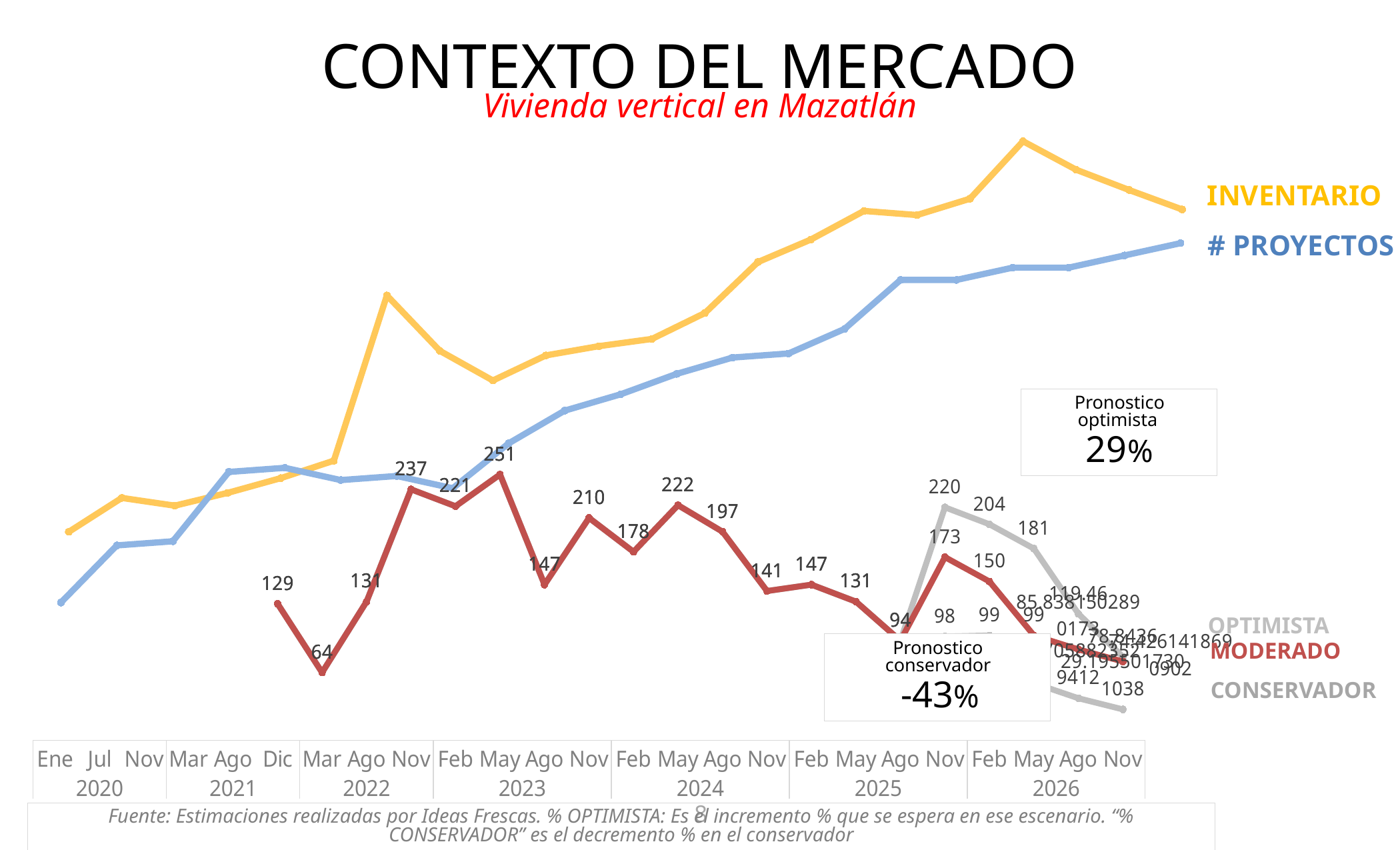
What is the highest data label shown on the OPTIMISTA (gray) line? 220 Does the # PROYECTOS (blue) line generally rise or fall from 2020 to 2026? rise What percentage is shown in the 'Pronostico conservador' box? -43% What is the first data label shown at the start of the MODERADO (red) line? 129 What is the highest data label shown on the MODERADO (red) line? 251 What is the difference between the highest (251) and lowest (64) labeled values on the MODERADO line? 187 What is the title of the chart on the slide? CONTEXTO DEL MERCADO How many series does the chart's legend list? 5 Which labeled value on the MODERADO line is larger, 237 or 221? 237 What percentage is shown in the 'Pronostico optimista' box? 29% What is the lowest data label shown on the MODERADO (red) line? 64 What type of chart is shown on the slide? line chart